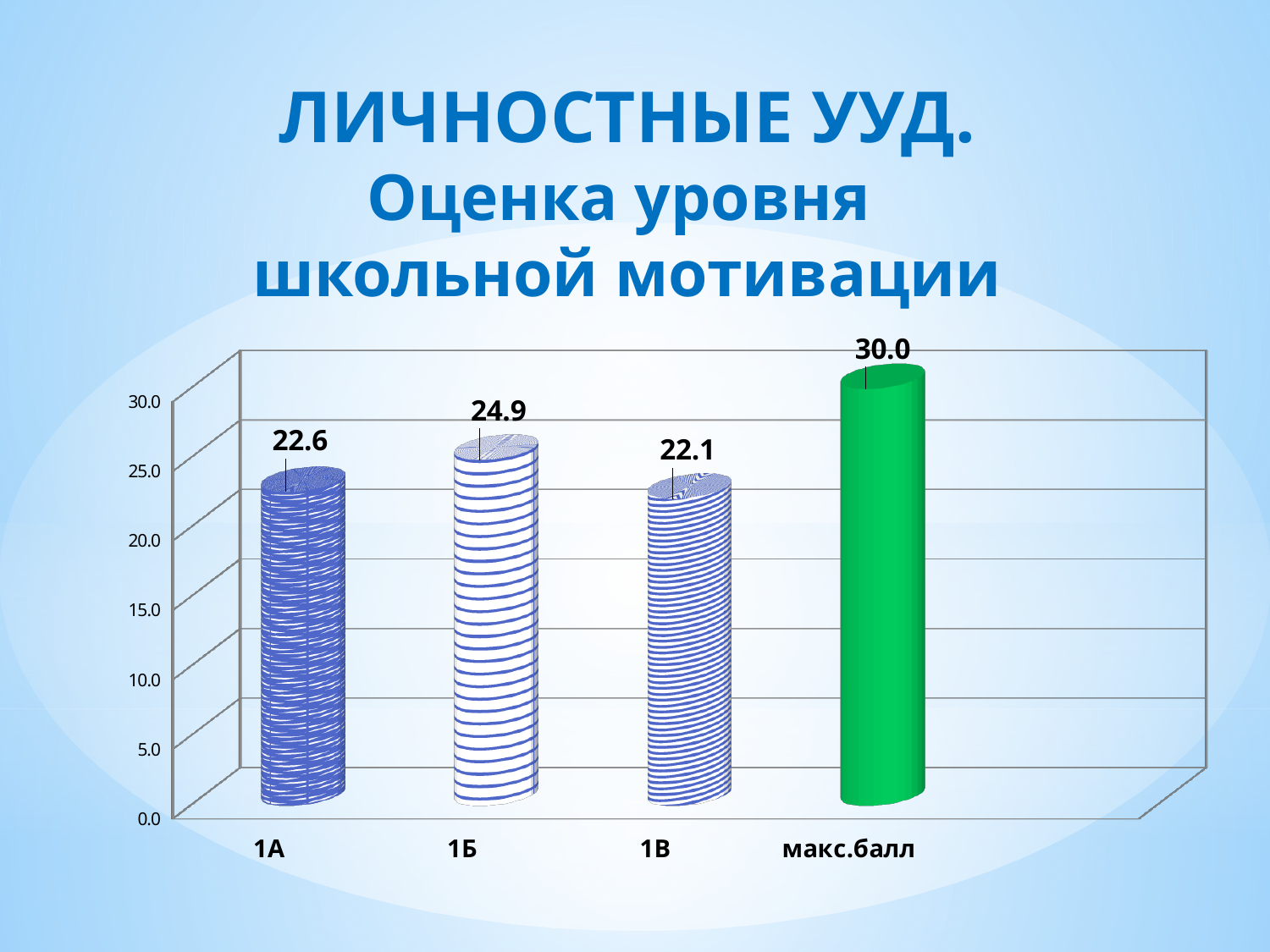
Is the value for 1А greater or less than 25.0? less What kind of chart is shown on the slide? bar chart What is the value for 1Б? 24.9 How many categories are shown on the x axis? 4 What is the value for макс.балл? 30.0 What is the difference between the value for макс.балл and the value for 1В? 7.9 What is the value for 1В? 22.1 Which category has the lowest value? 1В What is the value for 1А? 22.6 Which category has the highest value? макс.балл Which is larger, the value for 1Б or the value for 1В? 1Б What is the difference between the values for 1Б and 1А? 2.3